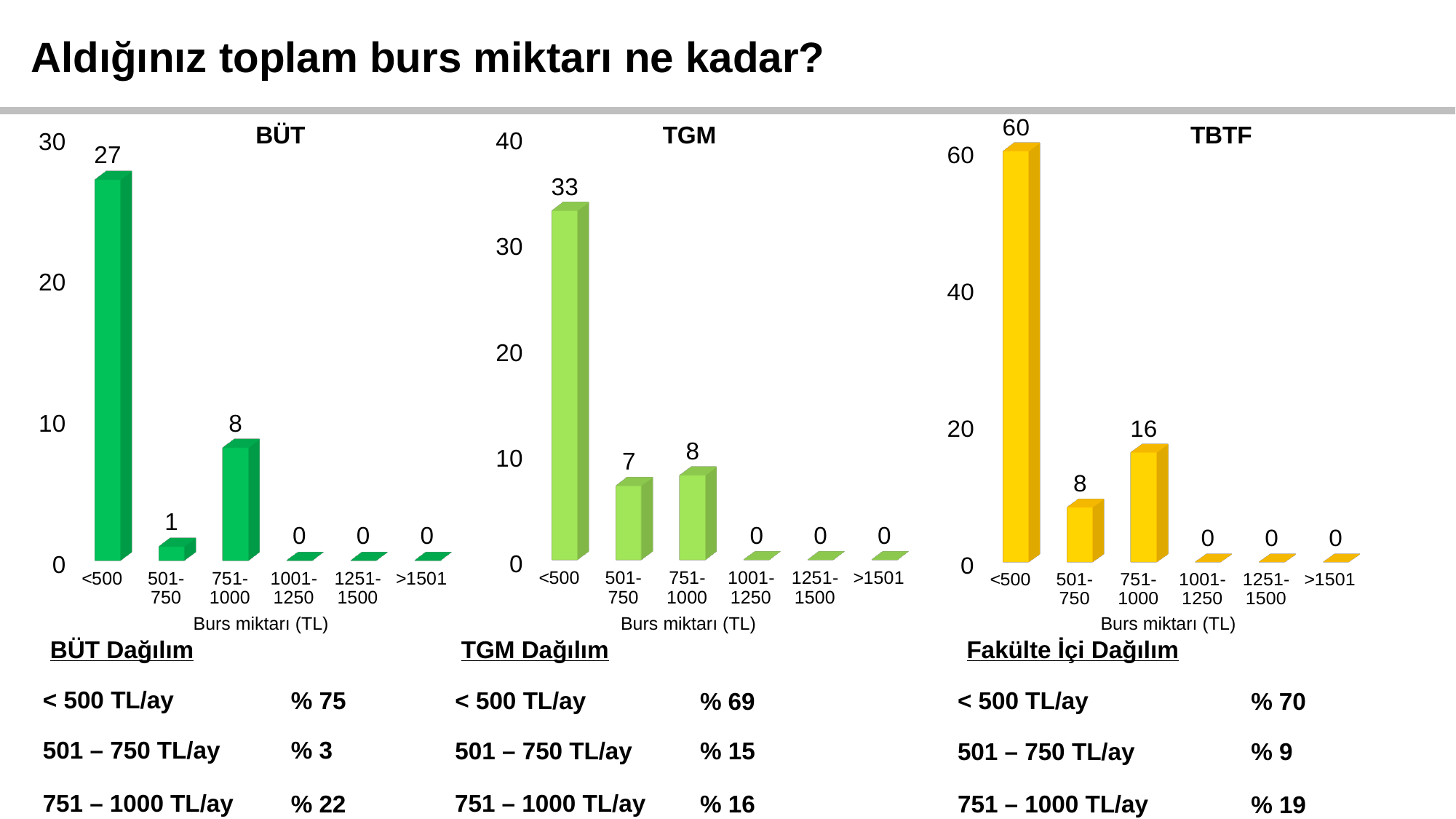
How many categories are shown on the x axis of the TGM chart? 6 In the TBTF chart, what is the value for the 751-1000 category? 16 In the TBTF chart, which category has the highest value? <500 In the TGM chart, what is the value for the 1001-1250 category? 0 In the TBTF chart, what is the difference between the <500 and 501-750 values? 52 In the BÜT chart, what is the value for the <500 category? 27 What is the x-axis title of the TBTF chart? Burs miktarı (TL) In the TGM chart, which is larger, the value for 501-750 or the value for 751-1000? 751-1000 In the TGM chart, what is the value for the 501-750 category? 7 What kind of chart is the BÜT chart? bar chart In the BÜT chart, what is the value for the 501-750 category? 1 In the BÜT chart, what is the difference between the <500 and 751-1000 values? 19